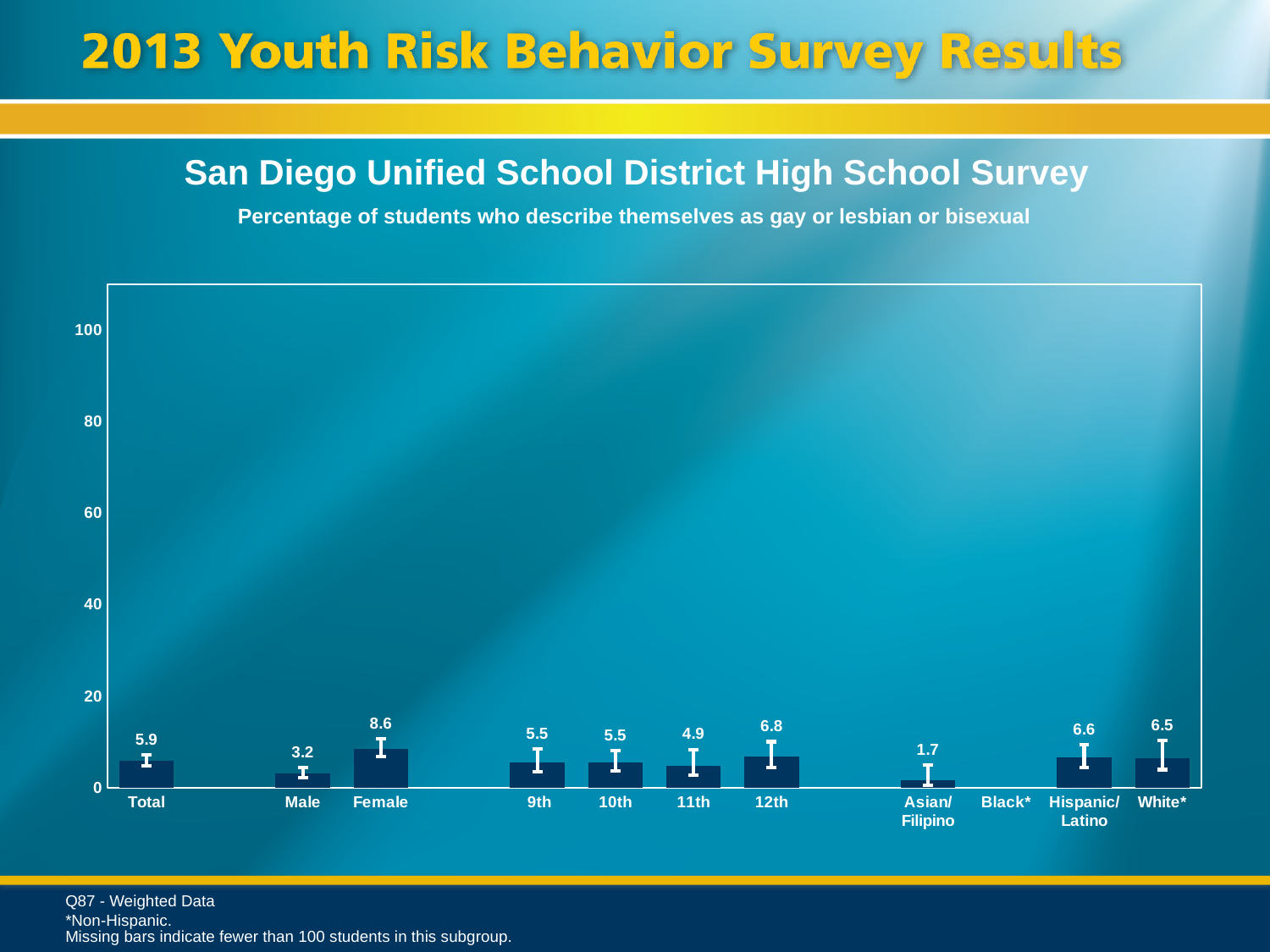
Which is larger, the value for Hispanic/Latino or the value for Male? Hispanic/Latino Which category has the highest value on the chart? Female What is the difference between the Female and Male values? 5.4 What is the value shown for Female students? 8.6 Among the categories with a plotted bar, which has the lowest value? Asian/Filipino Is the value for 9th grade students greater or less than 20? less What is the value shown for 12th grade students? 6.8 What is the value shown for Asian/Filipino students? 1.7 What percentage of students in the Total category describe themselves as gay or lesbian or bisexual? 5.9 Which category label on the x axis has no bar plotted? Black* What kind of chart is shown on the slide? Bar chart How many bars are plotted on the chart? 10